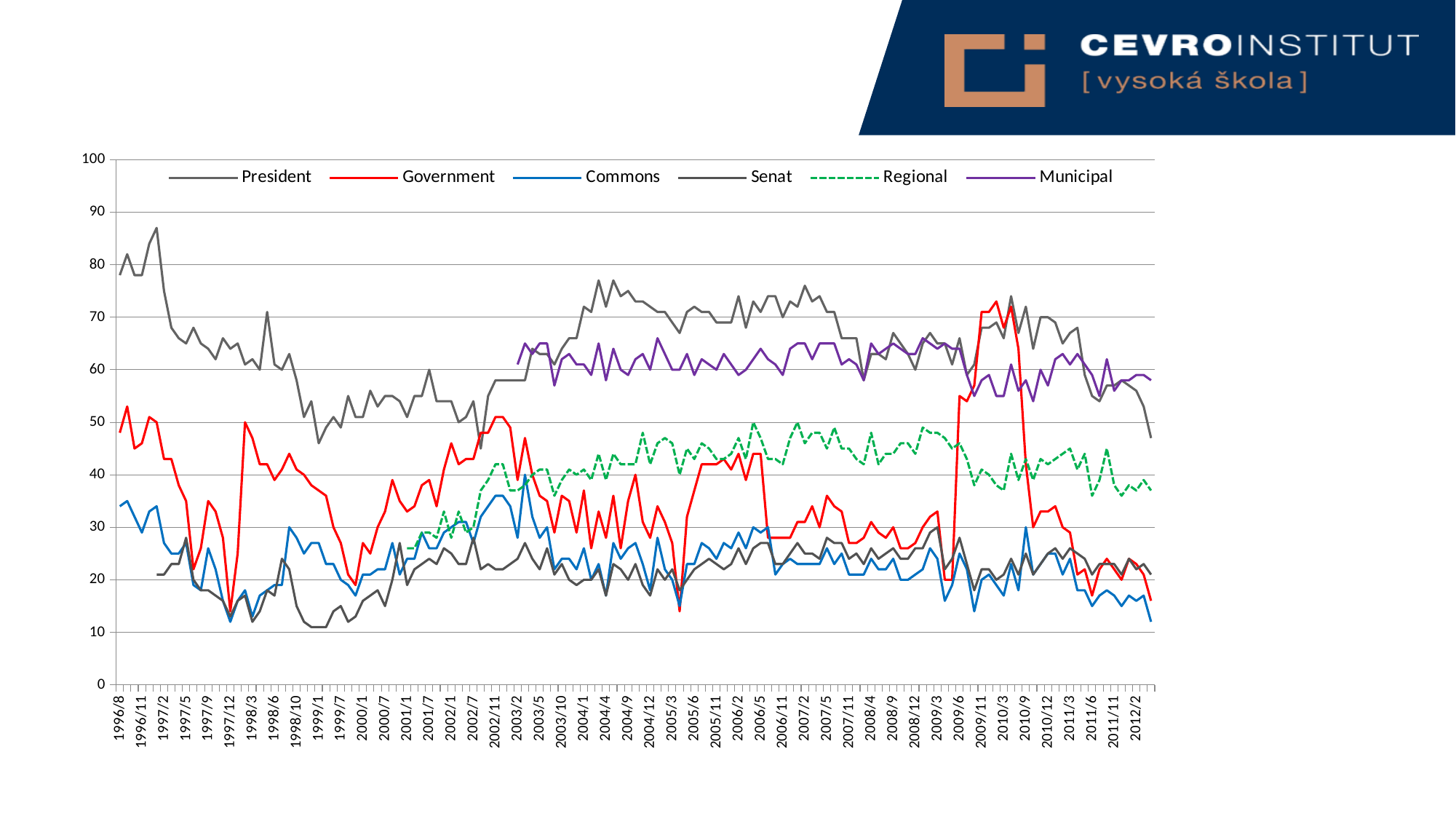
Which series is drawn with a dashed line? Regional Is the value for Municipal at 2003/2 greater or less than 50? greater Is the value for Senat at 1999/1 greater or less than 20? less Is the value for Commons at 2012/2 greater or less than 20? less Does the President series rise or fall between 1996/8 and 1999/1? fall What kind of chart is shown on the slide? line chart At 2008/4, which is larger: Municipal or Commons? Municipal Which series has the highest value at 1996/8? President How many series does the legend list? 6 What is the highest value shown on the vertical axis? 100